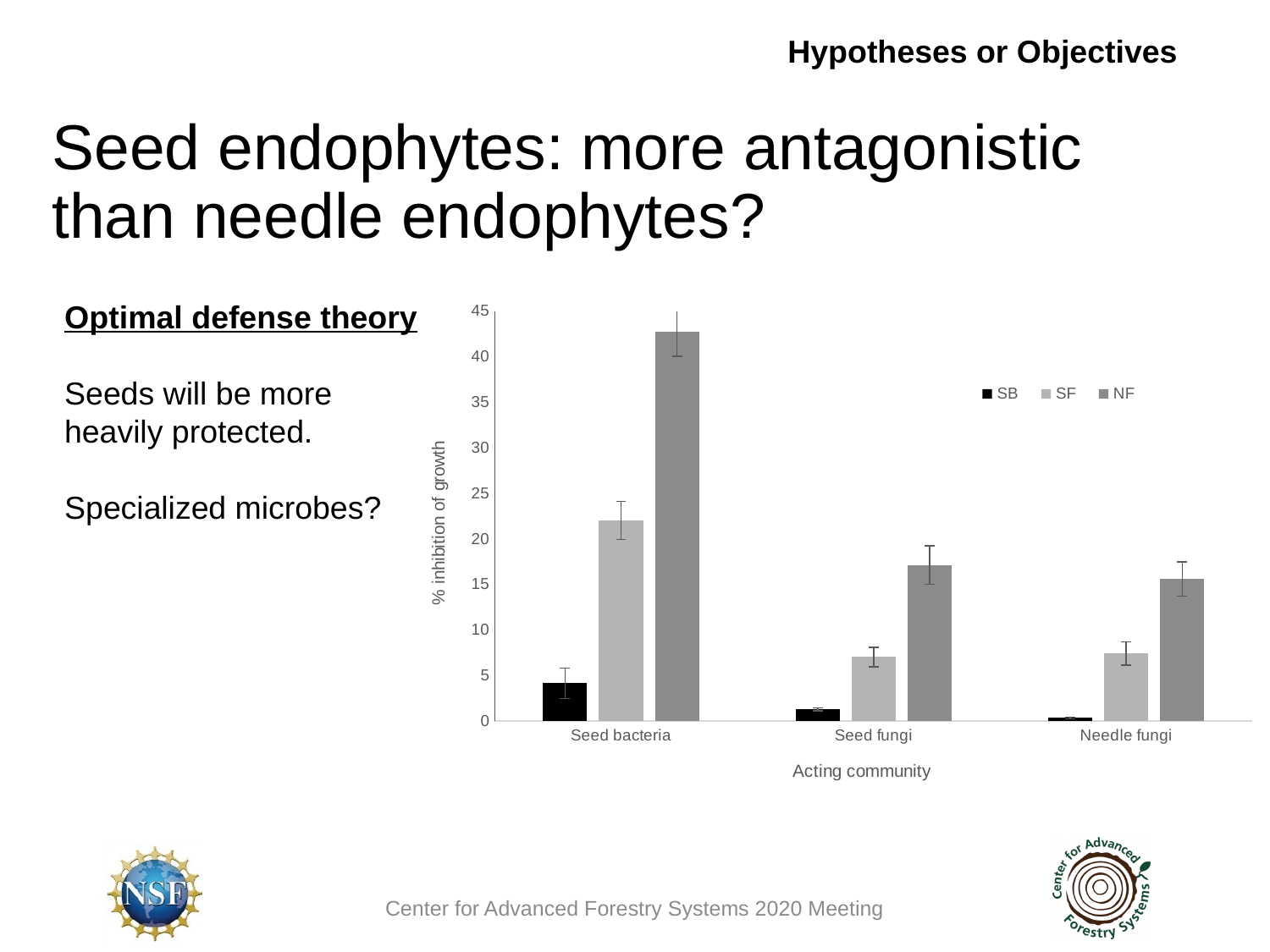
In which category is the NF bar the tallest? Seed bacteria How many categories are shown on the x axis of the chart? 3 Which series has the lowest bar in the Needle fungi category? SB How many series does the chart's legend list? 3 Which is larger: the SF value for Seed bacteria or the NF value for Seed fungi? SF value for Seed bacteria What kind of chart is shown on the slide? bar chart What is the label of the y axis of the chart? % inhibition of growth Which series has the highest bar in the Seed bacteria category? NF What is the label of the x axis of the chart? Acting community Is the NF value for Needle fungi greater or less than 20? less Is the NF value for Seed bacteria greater or less than 40? greater Is the SF value for Seed fungi greater or less than 10? less